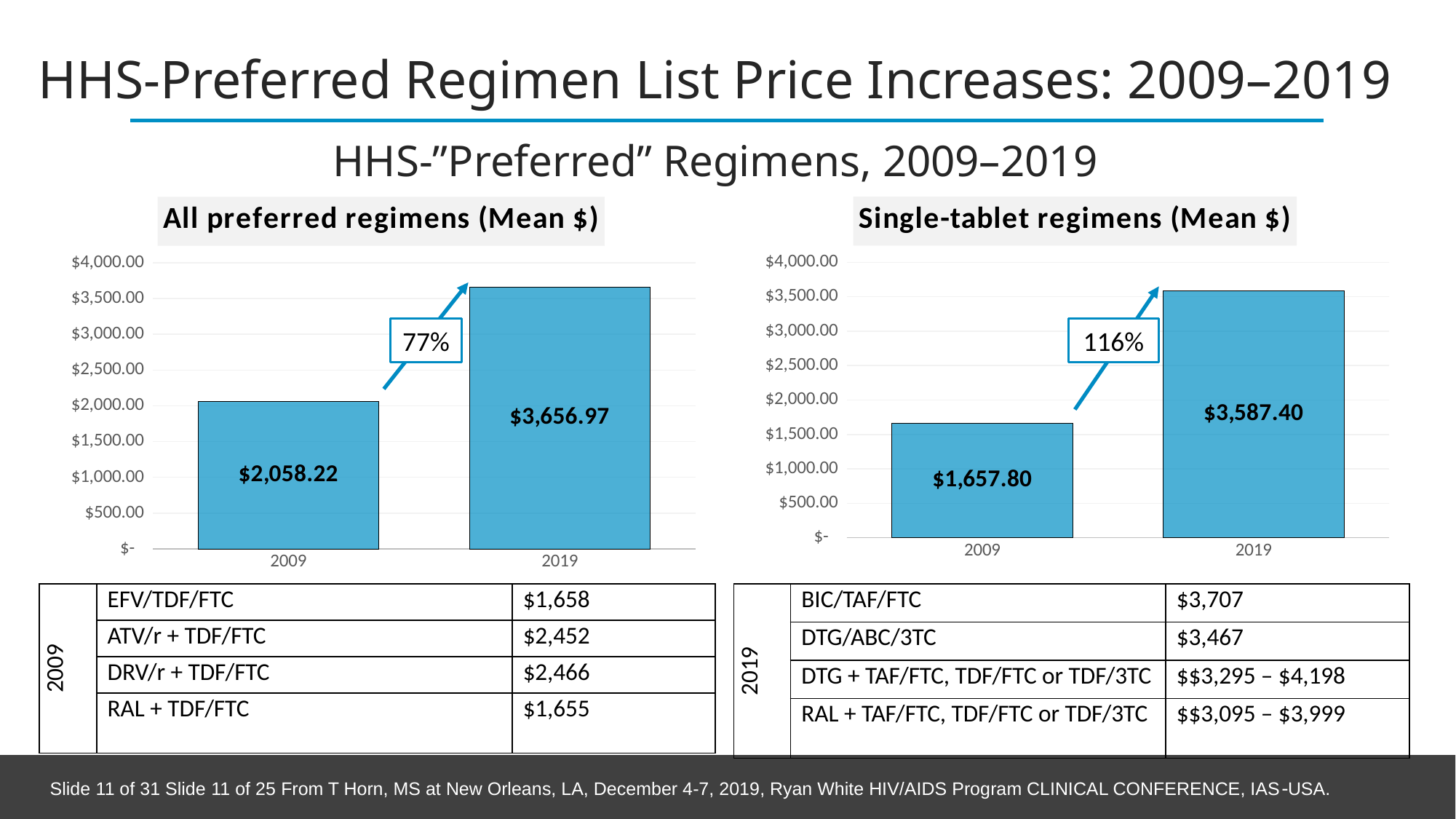
In the 'All preferred regimens (Mean $)' chart, what is the value for 2009? $2,058.22 What kind of chart is the 'Single-tablet regimens (Mean $)' chart? bar chart In the 'All preferred regimens (Mean $)' chart, what is the difference between the 2019 and 2009 values? $1,598.75 In the 'Single-tablet regimens (Mean $)' chart, what is the value for 2009? $1,657.80 In the 'All preferred regimens (Mean $)' chart, which year has the lowest value? 2009 In the 'All preferred regimens (Mean $)' chart, what is the value for 2019? $3,656.97 In the 'All preferred regimens (Mean $)' chart, is the value for 2009 greater or less than $2,500.00? less In the 'Single-tablet regimens (Mean $)' chart, what is the value for 2019? $3,587.40 In the 'All preferred regimens (Mean $)' chart, what percentage increase is shown in the annotation between 2009 and 2019? 77% In the 'Single-tablet regimens (Mean $)' chart, which year has the higher value? 2019 In the 'Single-tablet regimens (Mean $)' chart, what is the difference between the 2019 and 2009 values? $1,929.60 In the 'Single-tablet regimens (Mean $)' chart, what percentage increase is shown in the annotation between 2009 and 2019? 116%